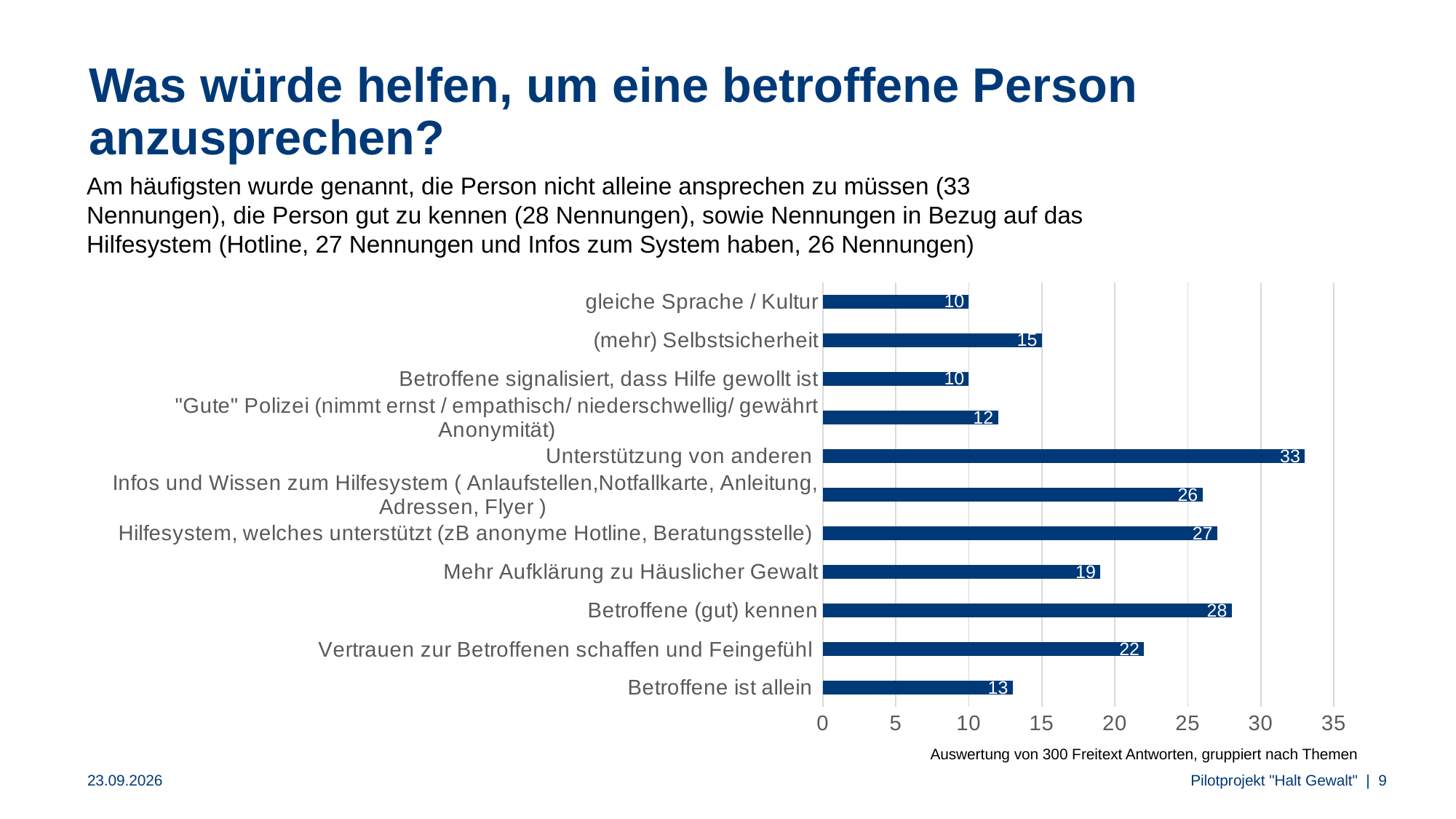
What is the value for "Betroffene (gut) kennen"? 28 What is the value for "Mehr Aufklärung zu Häuslicher Gewalt"? 19 What is the value for "Betroffene ist allein"? 13 What is the value for "Unterstützung von anderen"? 33 What kind of chart is shown on the slide? bar chart Which is larger: "(mehr) Selbstsicherheit" or "Mehr Aufklärung zu Häuslicher Gewalt"? Mehr Aufklärung zu Häuslicher Gewalt What is the difference between "Betroffene (gut) kennen" and "Vertrauen zur Betroffenen schaffen und Feingefühl"? 6 What is the highest tick value shown on the horizontal axis? 35 What is the difference between "Hilfesystem, welches unterstützt (zB anonyme Hotline, Beratungsstelle)" and "Infos und Wissen zum Hilfesystem"? 1 Is the value for "Vertrauen zur Betroffenen schaffen und Feingefühl" greater or less than 20? greater Which category has the highest value? Unterstützung von anderen How many categories are shown in the chart? 11